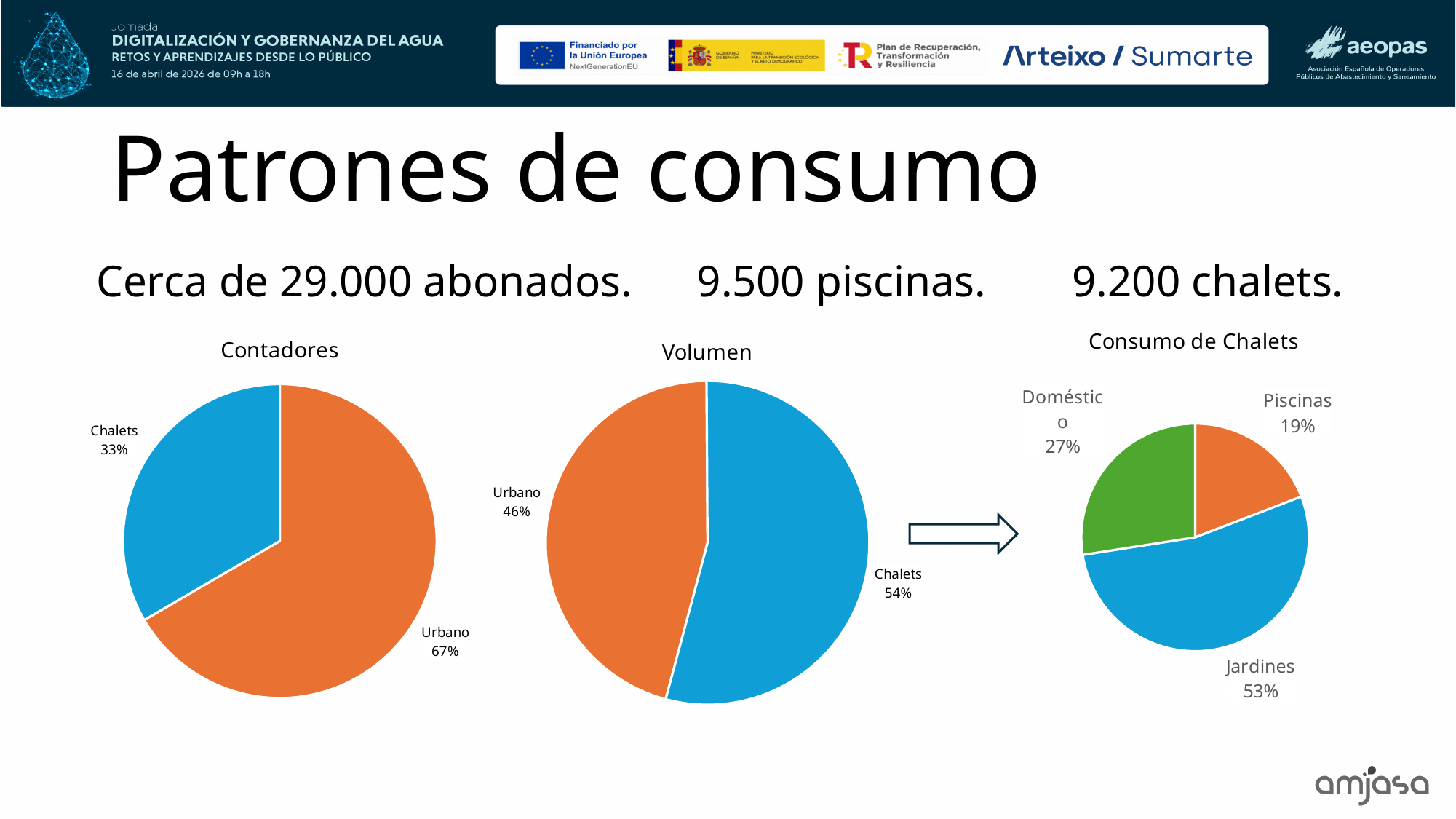
What kind of chart is the 'Volumen' chart? Pie chart How many slices does the 'Consumo de Chalets' chart have? 3 In the 'Consumo de Chalets' chart, what share do Piscinas have? 19% In the 'Volumen' chart, what share do Chalets have? 54% In the 'Consumo de Chalets' chart, which category has the largest slice? Jardines In the 'Volumen' chart, which is larger, Urbano or Chalets? Chalets In the 'Consumo de Chalets' chart, what share do Jardines have? 53% In the 'Contadores' chart, what is the difference in percentage points between Urbano and Chalets? 34 In the 'Contadores' chart, what share does Urbano have? 67% In the 'Contadores' chart, what share do Chalets have? 33% In the 'Consumo de Chalets' chart, which category has the smallest slice? Piscinas In the 'Volumen' chart, what share does Urbano have? 46%